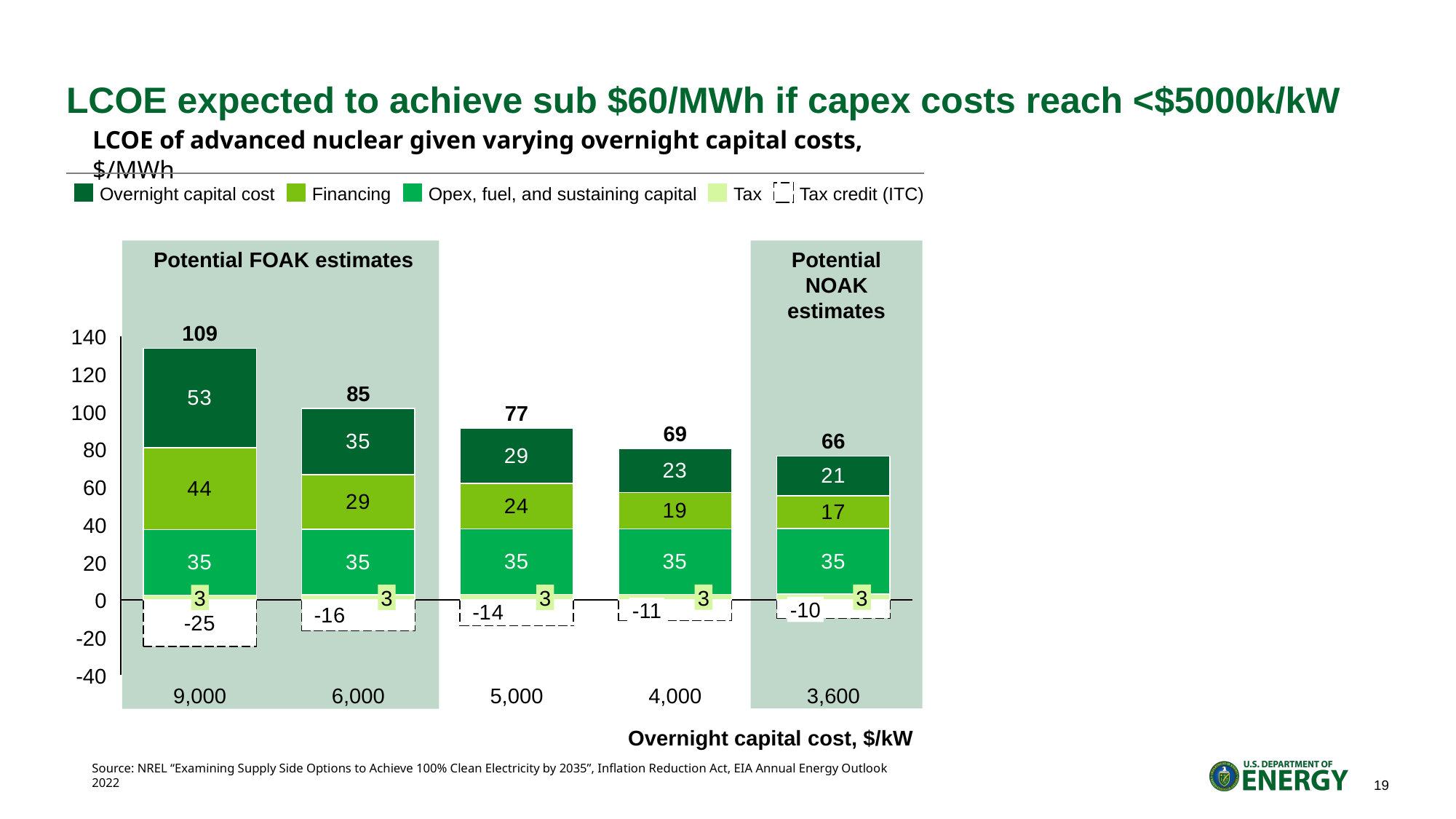
What is the Overnight capital cost component for the 6,000 $/kW bar? 35 What is the total LCOE label shown for the 9,000 $/kW overnight capital cost bar? 109 How many series does the legend list? 5 Which is larger: the Financing component at 9,000 $/kW or the Overnight capital cost component at 9,000 $/kW? Overnight capital cost (53) Do the total LCOE values rise or fall as you move from left to right along the x axis? Fall What kind of chart is shown on the slide? Stacked bar chart What is the difference between the total LCOE for 9,000 $/kW and 6,000 $/kW? 24 How many overnight capital cost categories are shown on the x axis? 5 What is the Tax credit (ITC) value for the 4,000 $/kW bar? -11 Which overnight capital cost category has the highest total LCOE? 9,000 What is the Financing component for the 5,000 $/kW bar? 24 Which overnight capital cost category has the lowest total LCOE? 3,600